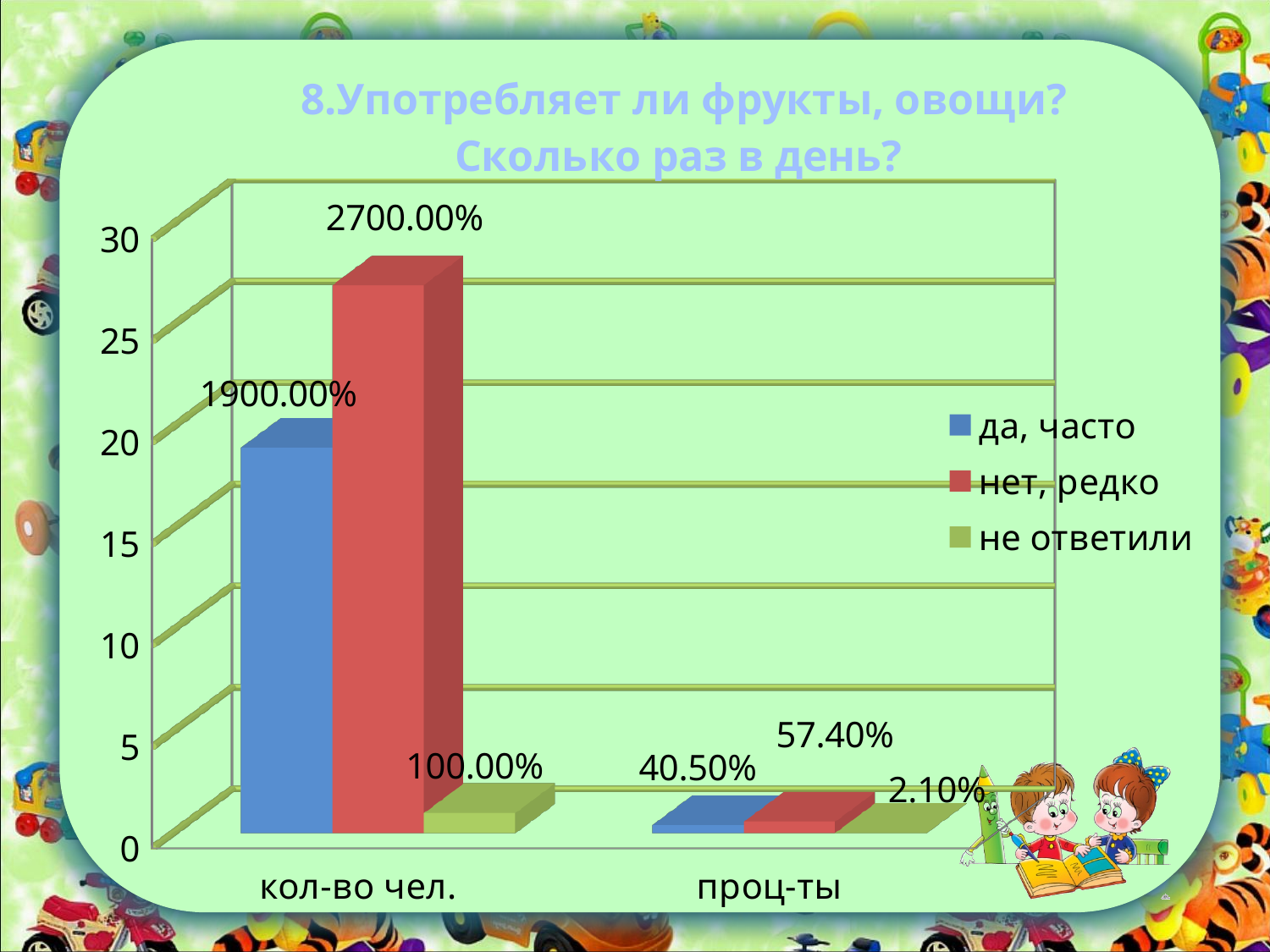
What is the data label for "нет, редко" in the "проц-ты" category? 57.40% How many categories are shown on the x axis? 2 What is the data label for "нет, редко" in the "кол-во чел." category? 2700.00% What is the data label for "да, часто" in the "кол-во чел." category? 1900.00% What is the data label for "не ответили" in the "кол-во чел." category? 100.00% Which series has the lowest value in the "проц-ты" category? не ответили What is the data label for "не ответили" in the "проц-ты" category? 2.10% What is the data label for "да, часто" in the "проц-ты" category? 40.50% What type of chart is shown on the slide? bar chart Which series has the highest value in the "кол-во чел." category? нет, редко In the "проц-ты" category, which is larger: "да, часто" or "нет, редко"? нет, редко How many series does the legend list? 3